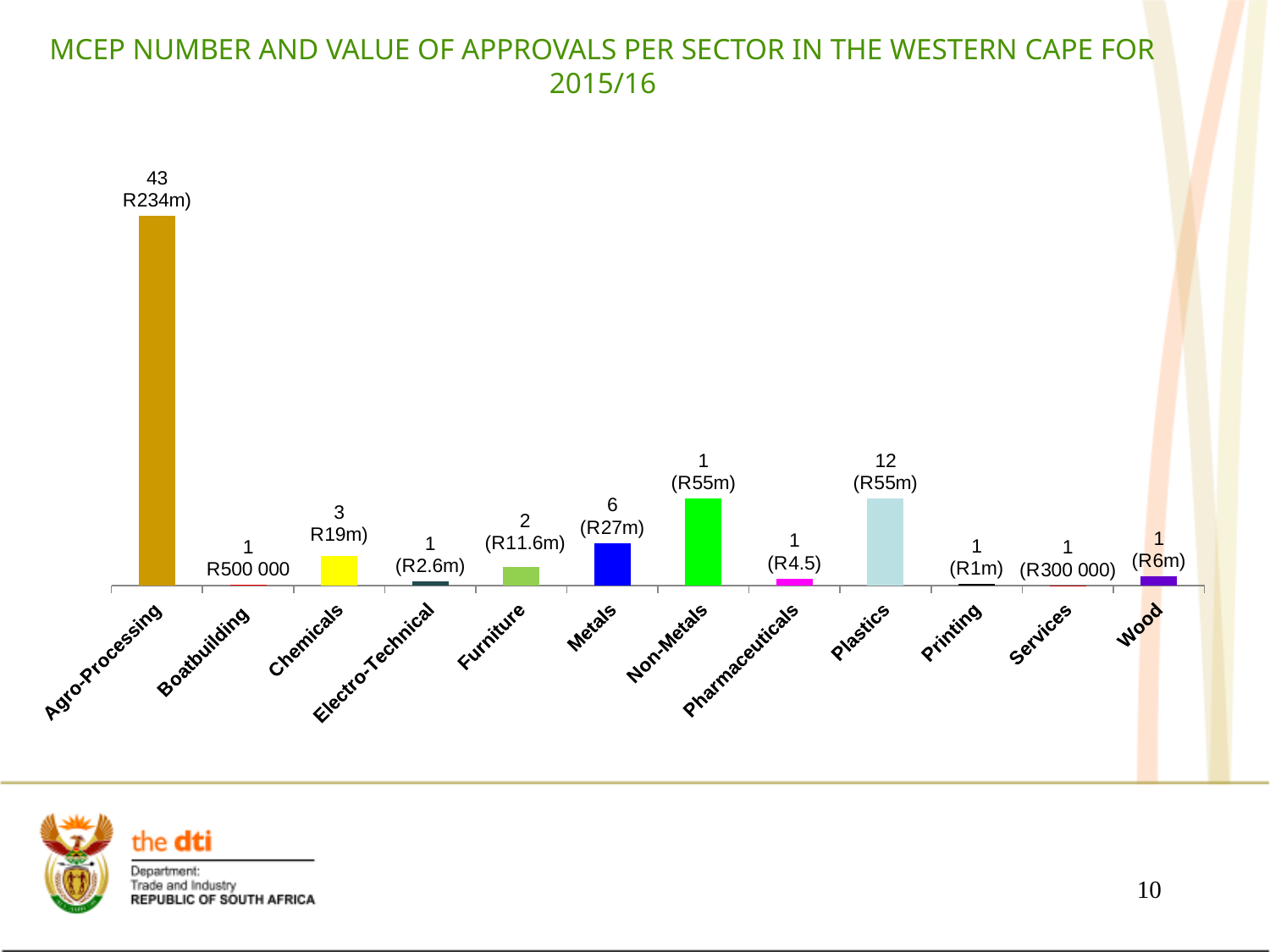
Which sector has the larger bar, Metals or Furniture? Metals How many more approvals does Agro-Processing have than Plastics? 31 What kind of chart is shown on the slide? bar chart How many sectors are shown on the x axis of the chart? 12 How many approvals are shown for Plastics? 12 What is the value of approvals shown for Boatbuilding? R500 000 What is the title of the chart on the slide? MCEP NUMBER AND VALUE OF APPROVALS PER SECTOR IN THE WESTERN CAPE FOR 2015/16 Which sector has the lowest value of approvals shown? Services Which sector has the tallest bar in the chart? Agro-Processing What is the value of approvals shown for Agro-Processing? R234m What is the value of approvals shown for Metals? R27m How many MCEP approvals are shown for Agro-Processing? 43